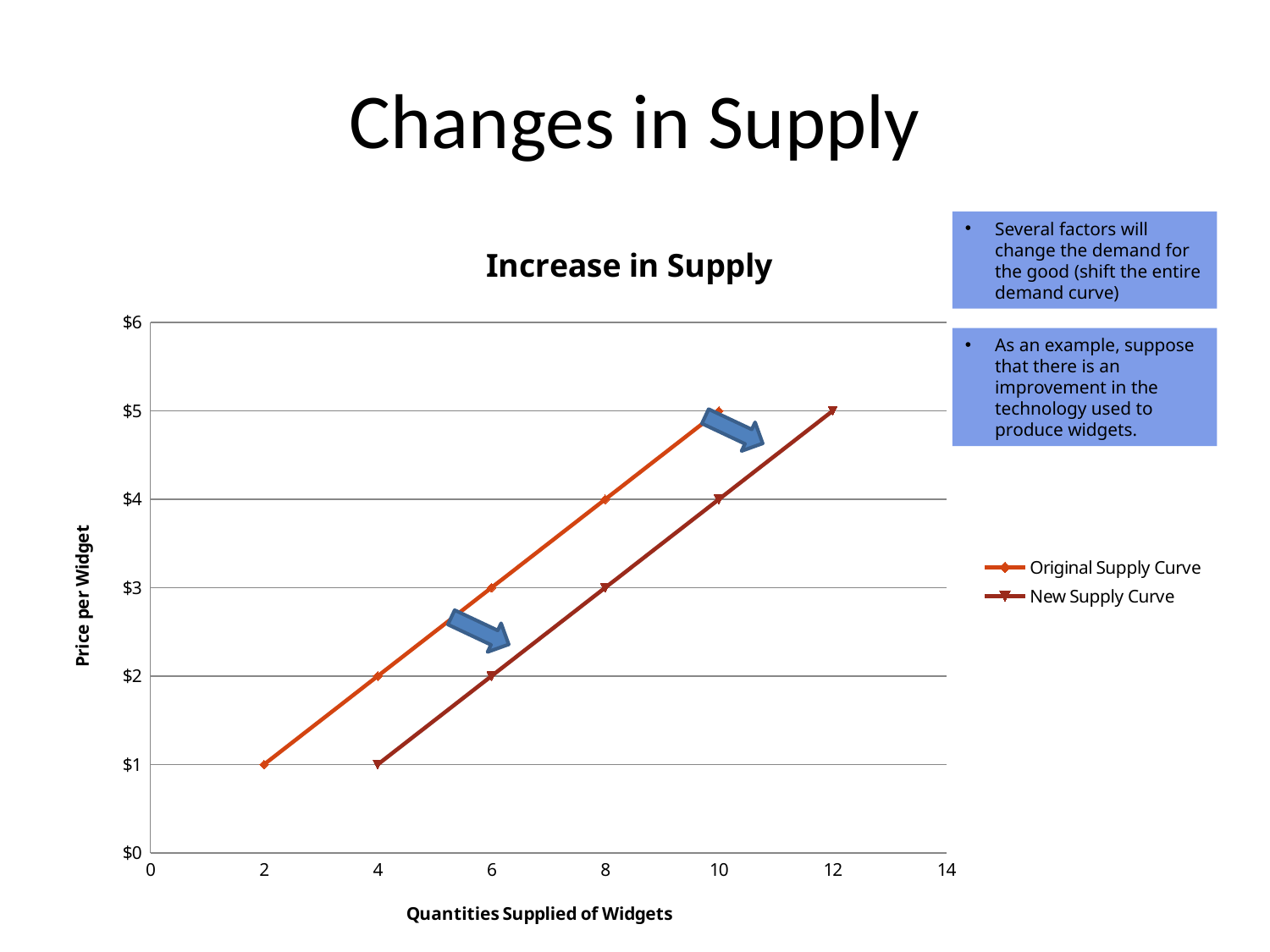
How many series does the chart legend list? 2 What kind of chart is shown on the slide? line chart On the Original Supply Curve, what quantity is supplied at a price of $3? 6 How many data points are plotted on the Original Supply Curve? 5 At a price of $2, which curve shows the larger quantity supplied, the Original Supply Curve or the New Supply Curve? New Supply Curve On the New Supply Curve, what quantity is supplied at a price of $3? 8 Does the price per widget rise or fall as the quantity supplied increases along the Original Supply Curve? rise At a price of $5, how much larger is the quantity supplied on the New Supply Curve than on the Original Supply Curve? 2 What is the highest price shown on the Original Supply Curve? $5 What is the title of the chart? Increase in Supply On the New Supply Curve, what is the price per widget when the quantity supplied is 12? $5 What is the label of the x axis? Quantities Supplied of Widgets